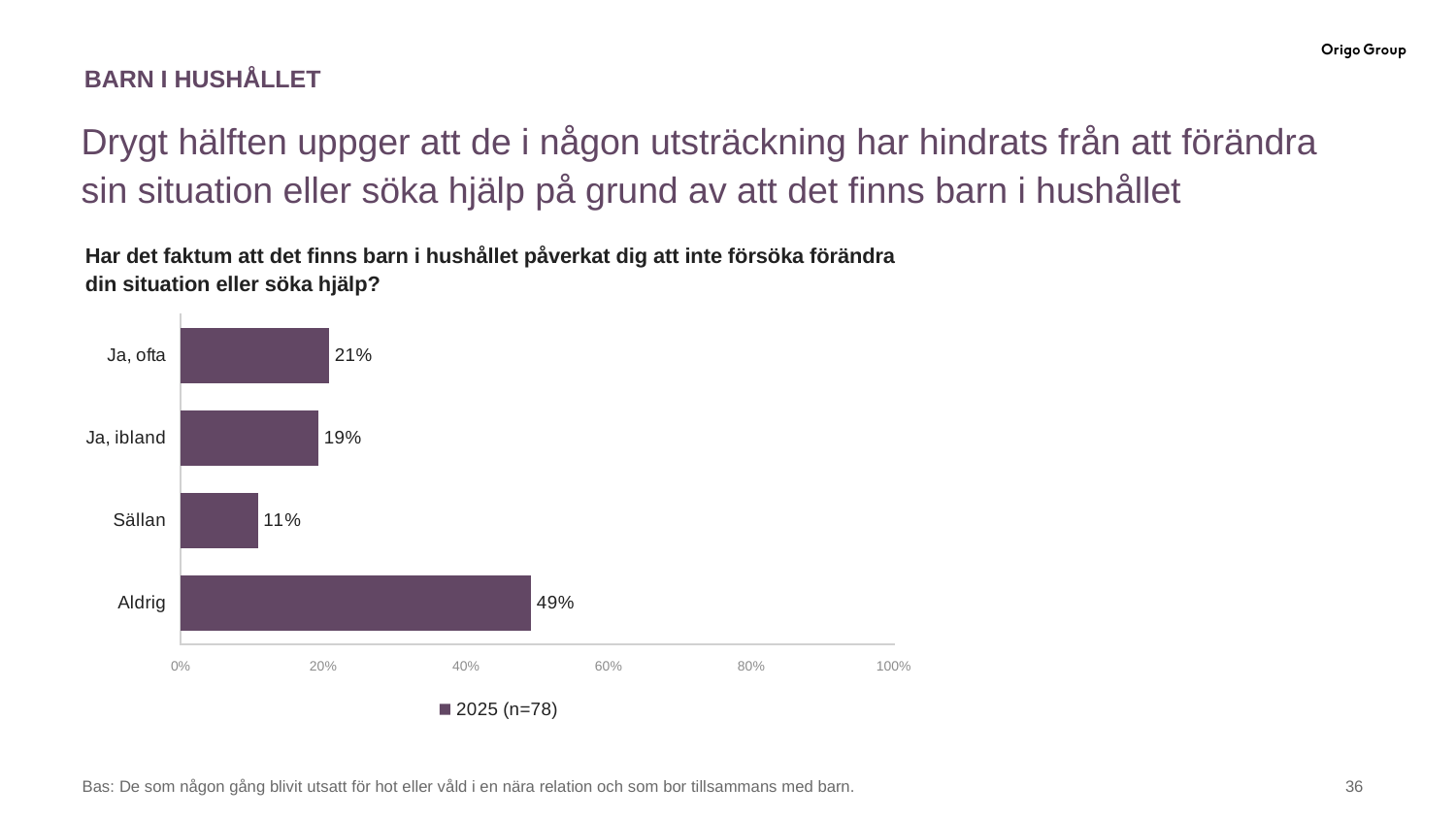
What is the value for "Sällan"? 11% How many categories are shown in the chart? 4 What kind of chart is shown on the slide? Bar chart Is the value for "Aldrig" greater or less than 40%? greater What is the value for "Aldrig"? 49% What series does the legend list? 2025 (n=78) What is the value for "Ja, ofta"? 21% What is the value for "Ja, ibland"? 19% Which is larger, the value for "Ja, ofta" or the value for "Sällan"? Ja, ofta What is the difference between the values for "Aldrig" and "Ja, ofta"? 28% Which category has the highest value? Aldrig Which category has the lowest value? Sällan